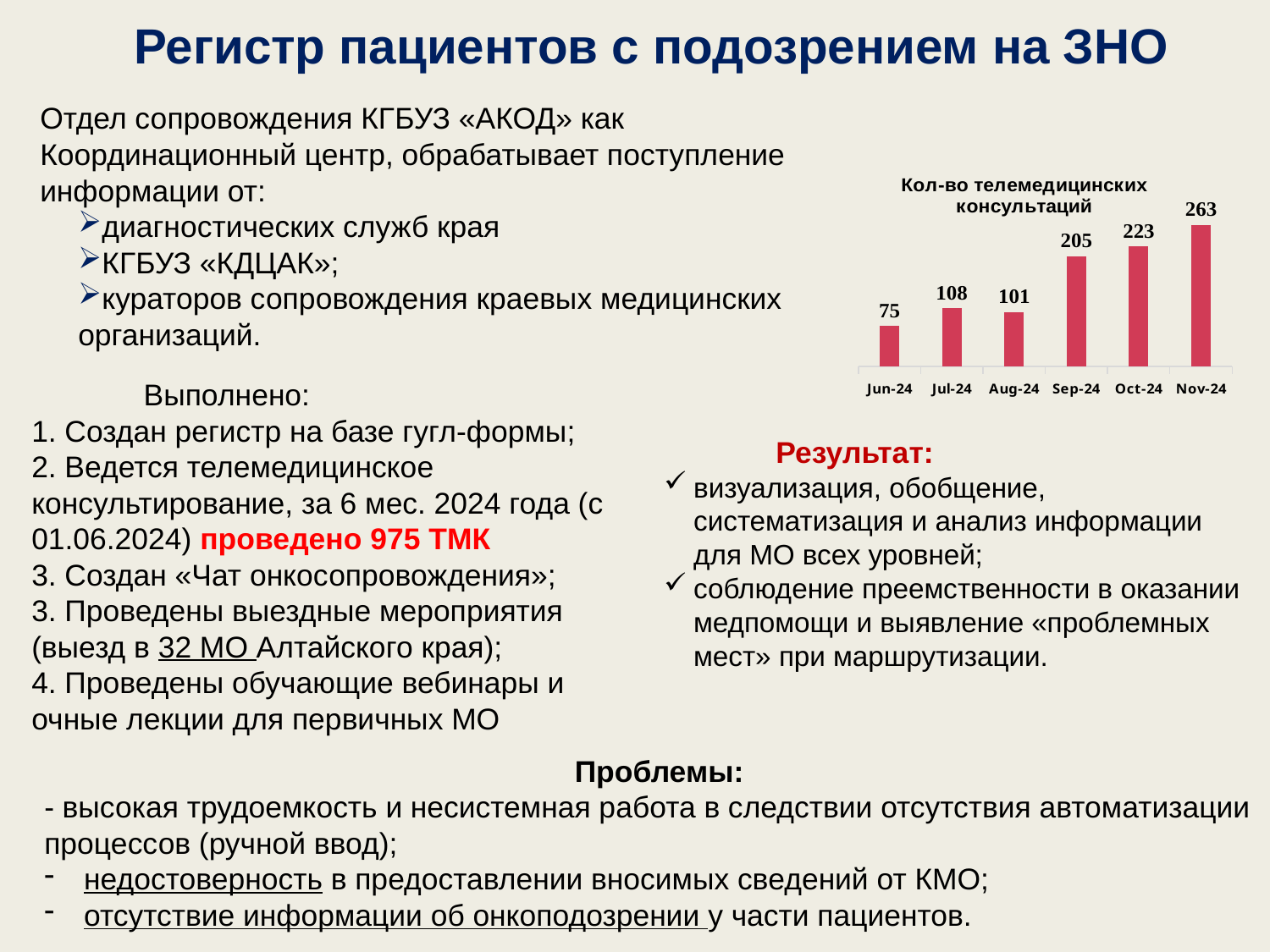
What is the difference between the values for Jul-24 and Aug-24? 7 What is the value for Sep-24? 205 Which is larger, the value for Jul-24 or the value for Aug-24? Jul-24 What is the title of the chart? Кол-во телемедицинских консультаций What is the value for Nov-24? 263 What is the difference between the values for Nov-24 and Oct-24? 40 What type of chart is shown on the slide? bar chart Which month has the highest value? Nov-24 Do the values generally rise or fall from Jun-24 to Nov-24? rise How many months are plotted in the chart? 6 What is the value for Jun-24? 75 Which month has the lowest value? Jun-24